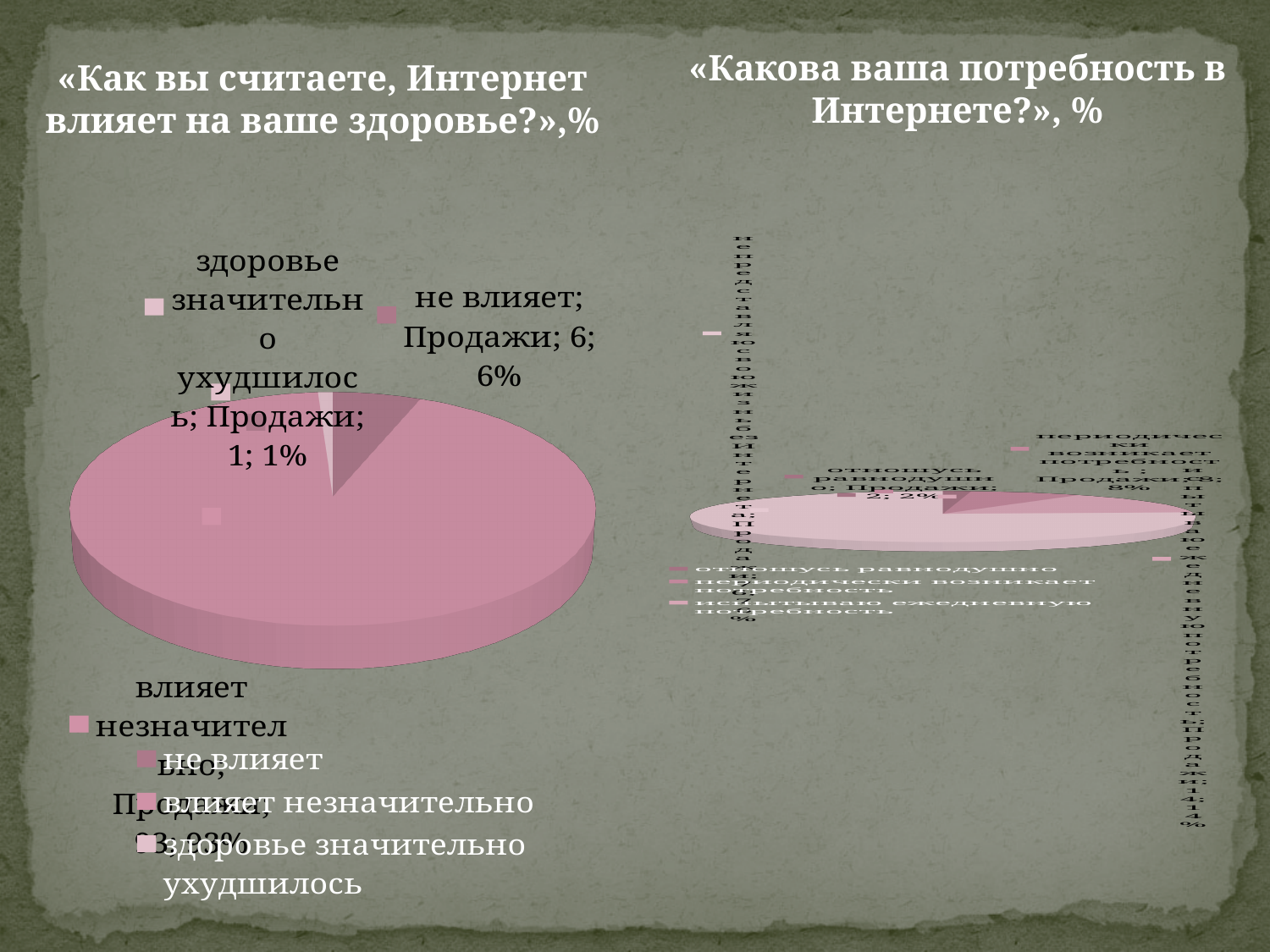
In the left chart, «Как вы считаете, Интернет влияет на ваше здоровье?», which category has the smallest slice? здоровье значительно ухудшилось In the left chart, «Как вы считаете, Интернет влияет на ваше здоровье?», what is the difference in percentage points between «не влияет» and «здоровье значительно ухудшилось»? 5 How many entries does the legend of the left chart, «Как вы считаете, Интернет влияет на ваше здоровье?», list? 3 In the left chart, «Как вы считаете, Интернет влияет на ваше здоровье?», what percentage is shown for «не влияет»? 6% In the left chart, «Как вы считаете, Интернет влияет на ваше здоровье?», which is larger: «не влияет» or «здоровье значительно ухудшилось»? не влияет In the right chart, «Какова ваша потребность в Интернете?», what percentage is shown for «отношусь равнодушно»? 2% What kind of chart is the left chart, «Как вы считаете, Интернет влияет на ваше здоровье?»? pie chart In the right chart, «Какова ваша потребность в Интернете?», what percentage is shown for «периодически возникает потребность»? 8% In the left chart, «Как вы считаете, Интернет влияет на ваше здоровье?», which category has the largest slice? влияет незначительно What kind of chart is the right chart, «Какова ваша потребность в Интернете?»? pie chart In the left chart, «Как вы считаете, Интернет влияет на ваше здоровье?», what percentage is shown for «здоровье значительно ухудшилось»? 1%